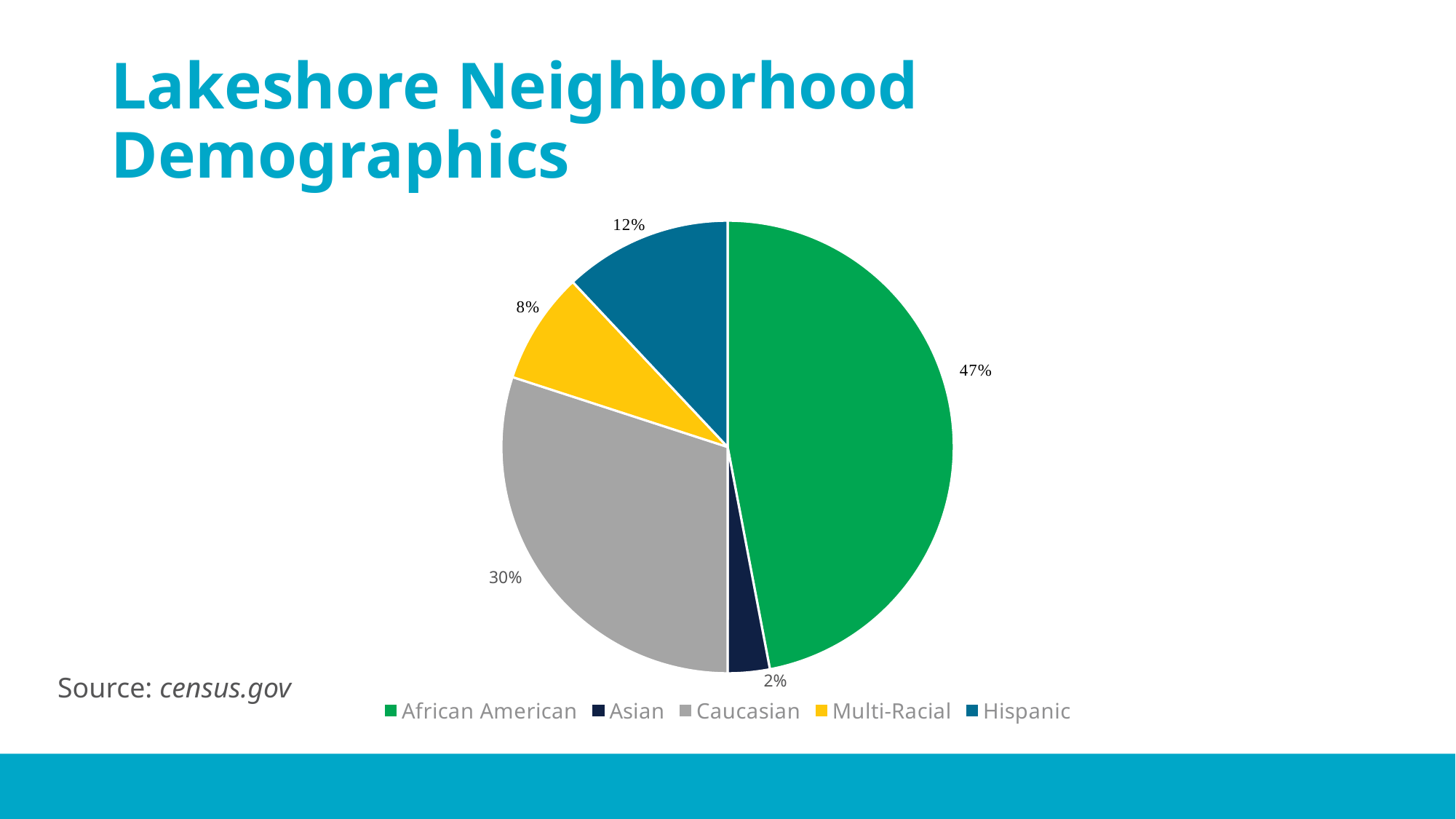
What colour is the Caucasian slice? Grey Which category has the largest slice of the pie? African American What percentage of the pie is African American? 47% Which category has the smallest slice of the pie? Asian What percentage of the pie is Asian? 2% What percentage of the pie is Caucasian? 30% What is the difference in percentage points between the African American and Caucasian slices? 17 Which slice is larger, Hispanic or Multi-Racial? Hispanic What kind of chart is shown on the slide? Pie chart How many categories does the pie chart show? 5 What percentage of the pie is Hispanic? 12% What percentage of the pie is Multi-Racial? 8%